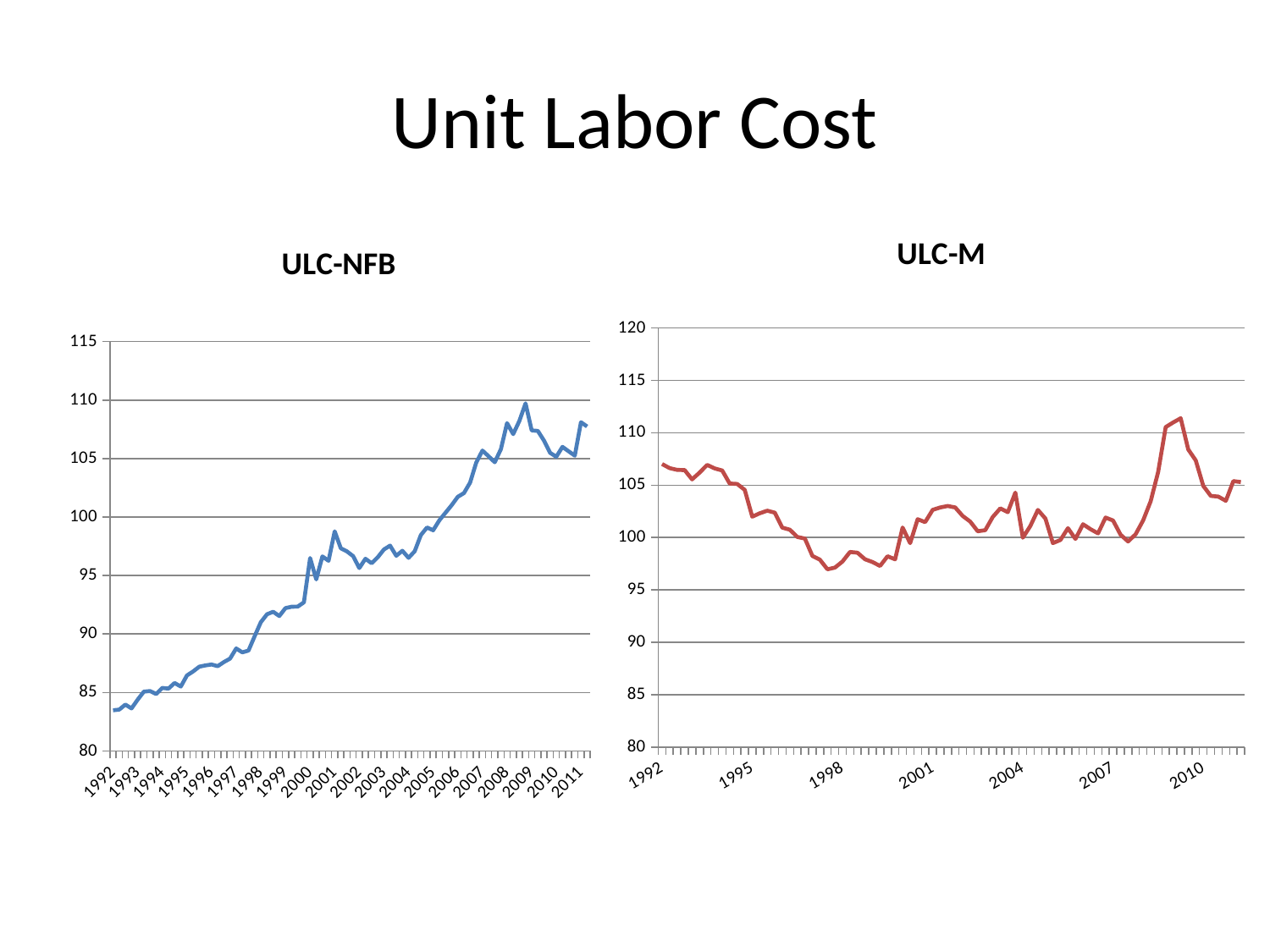
What is the title of the chart on the right? ULC-M What kind of chart is the ULC-M chart on the right? line chart In the ULC-NFB chart, is the value at the start of 1992 greater or less than 85? less In the ULC-M chart, is the lowest value around 1998 greater or less than 100? less In the ULC-M chart, is the peak value around 2009 greater or less than 110? greater In the ULC-M chart, do the values fall or rise between 1992 and 1998? fall What kind of chart is the ULC-NFB chart on the left? line chart What colour is the line in the ULC-NFB chart? blue In the ULC-NFB chart, do the values generally rise or fall from 1992 to 2011? rise